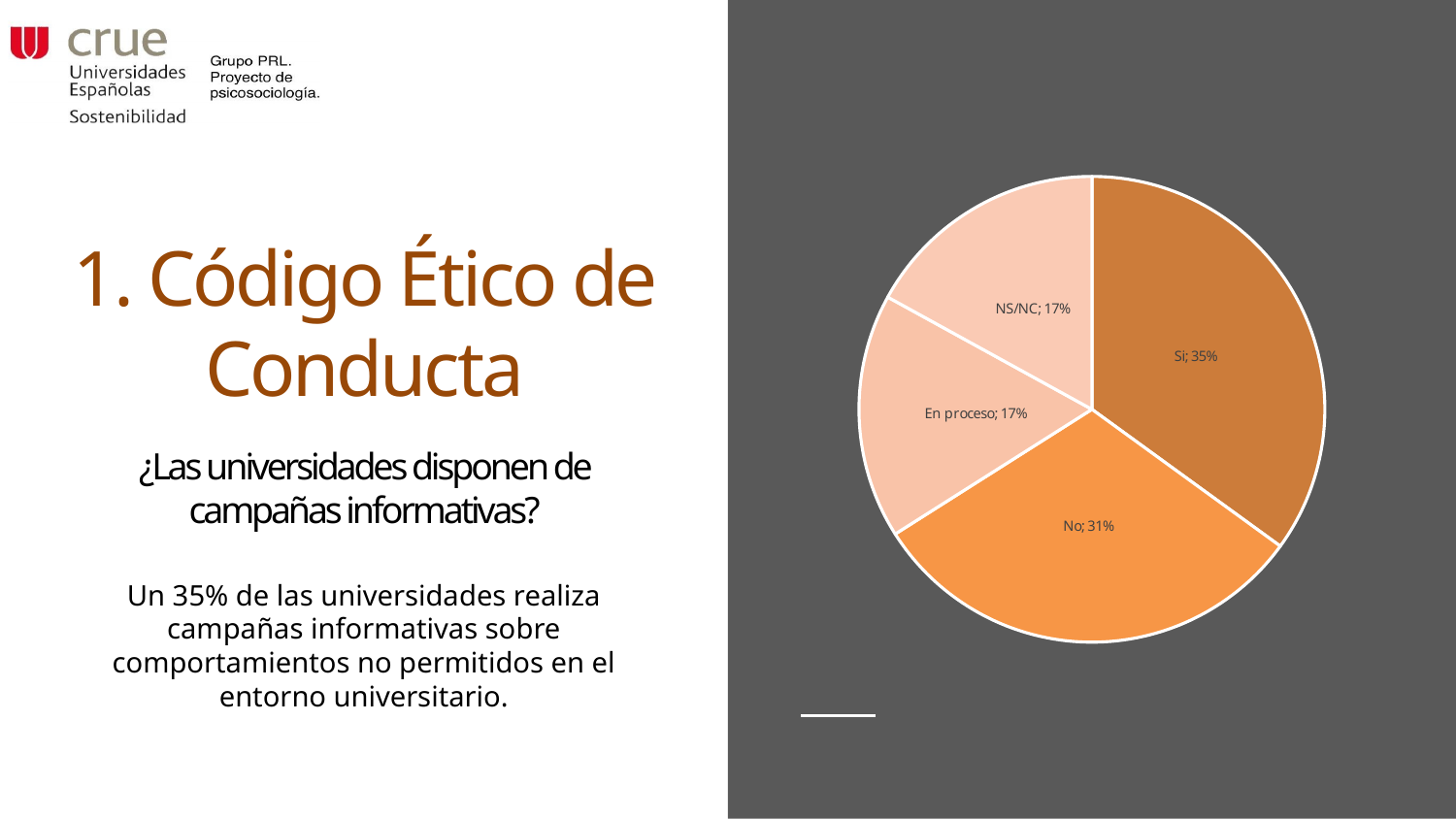
What percentage of the pie is labelled "No"? 31% What kind of chart is shown on the slide? pie chart What percentage of the pie is labelled "NS/NC"? 17% What is the combined share of the "Si" and "No" slices? 66% What percentage of the pie is labelled "En proceso"? 17% Which is larger, the "No" slice or the "En proceso" slice? No Which slice of the pie is the largest? Si How many slices does the pie chart have? 4 What is the difference in percentage points between the "Si" slice and the "No" slice? 4 Which two slices of the pie have the same value? En proceso and NS/NC What percentage of the pie is labelled "Si"? 35% What is the combined share of the "En proceso" and "NS/NC" slices? 34%